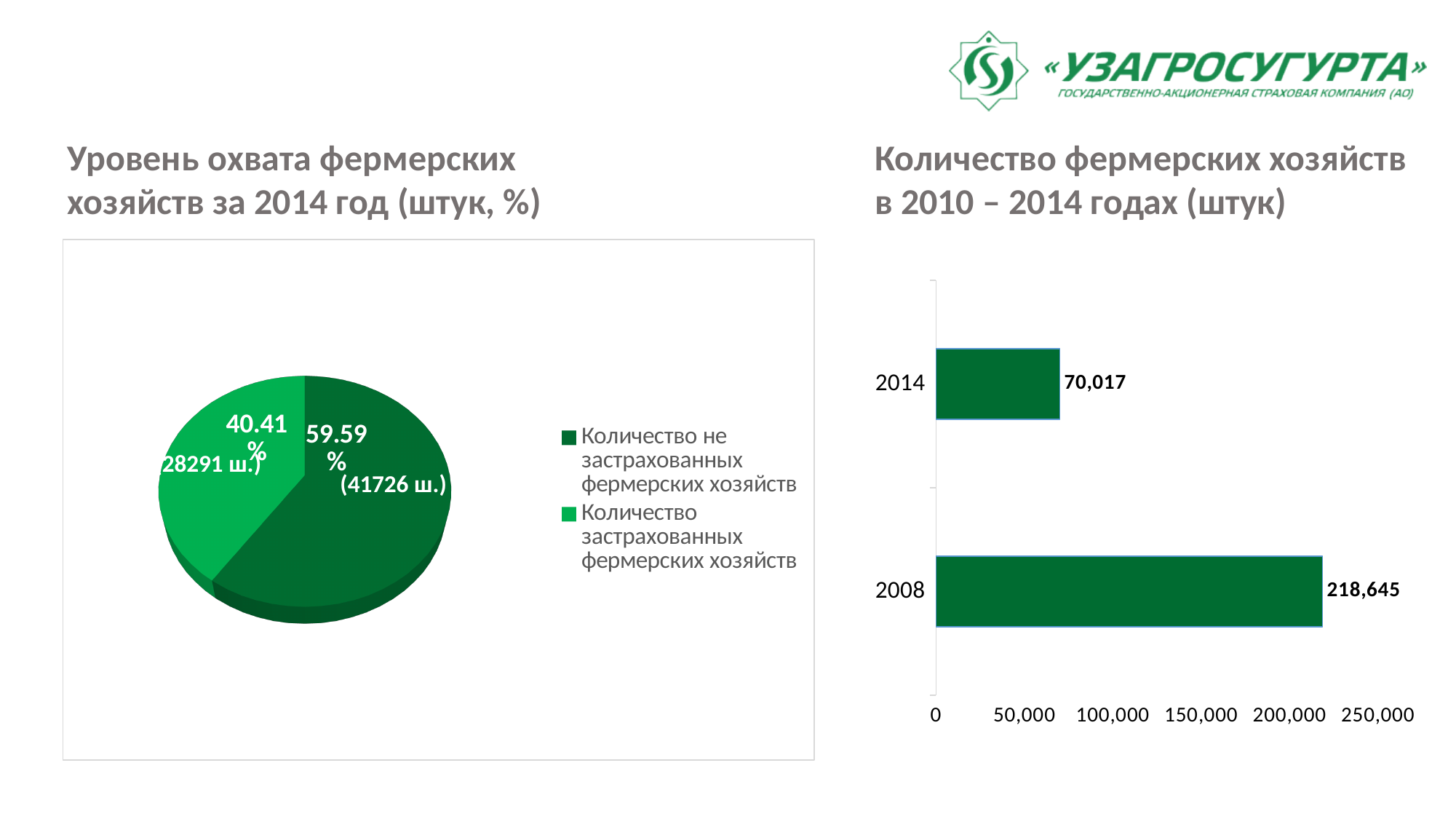
In the bar chart on the right, which year has the lower value? 2014 In the pie chart on the left, what number of farms is shown for "Количество застрахованных фермерских хозяйств"? 28291 ш. In the bar chart on the right, what is the difference between the values for 2008 and 2014? 148,628 In the pie chart titled "Уровень охвата фермерских хозяйств за 2014 год (штук, %)", what percentage share is shown for "Количество не застрахованных фермерских хозяйств"? 59.59% What kind of chart is the chart on the right of the slide? bar chart In the bar chart titled "Количество фермерских хозяйств в 2010 – 2014 годах (штук)", what is the value for 2008? 218,645 In the bar chart on the right, how many years are shown? 2 In the pie chart on the left, how many entries does the legend list? 2 In the pie chart on the left, what percentage share is shown for "Количество застрахованных фермерских хозяйств"? 40.41% In the bar chart on the right, is the value for 2008 greater or less than 200,000? greater In the bar chart titled "Количество фермерских хозяйств в 2010 – 2014 годах (штук)", what is the value for 2014? 70,017 In the bar chart on the right, which year has the higher value? 2008